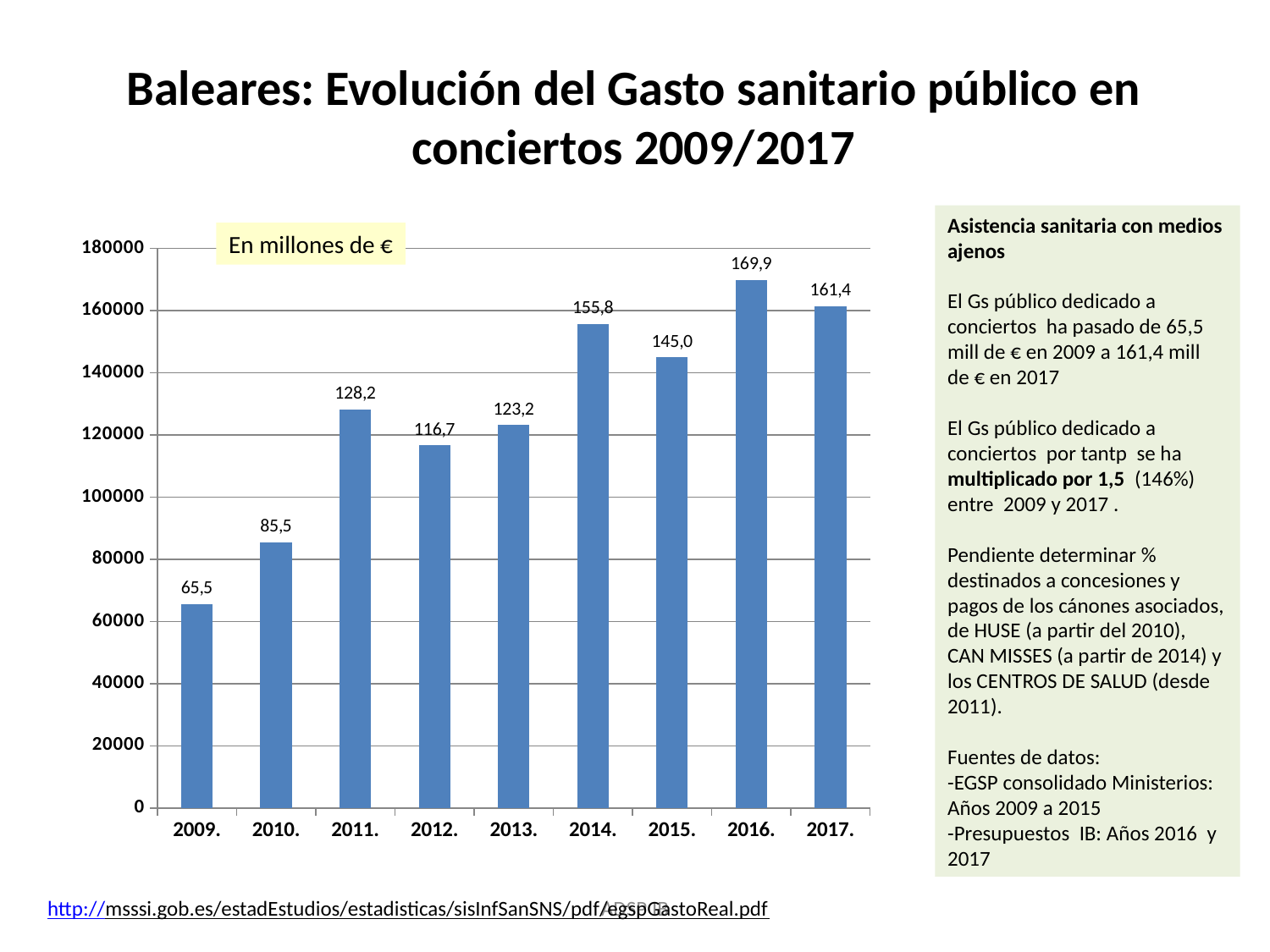
What is the value shown for 2009? 65,5 What is the difference between the values for 2017 and 2009? 95,9 Which year has the highest value? 2016 How many years are shown on the x axis? 9 Which year has the lowest value? 2009 What is the value shown for 2014? 155,8 Which is larger, the value for 2011 or the value for 2012? 2011 What is the difference between the values for 2016 and 2015? 24,9 Is the bar for 2013 greater or less than 120000 on the axis? greater What is the value shown for 2017? 161,4 What unit is indicated in the label box inside the chart? En millones de € What type of chart is shown on the slide? bar chart